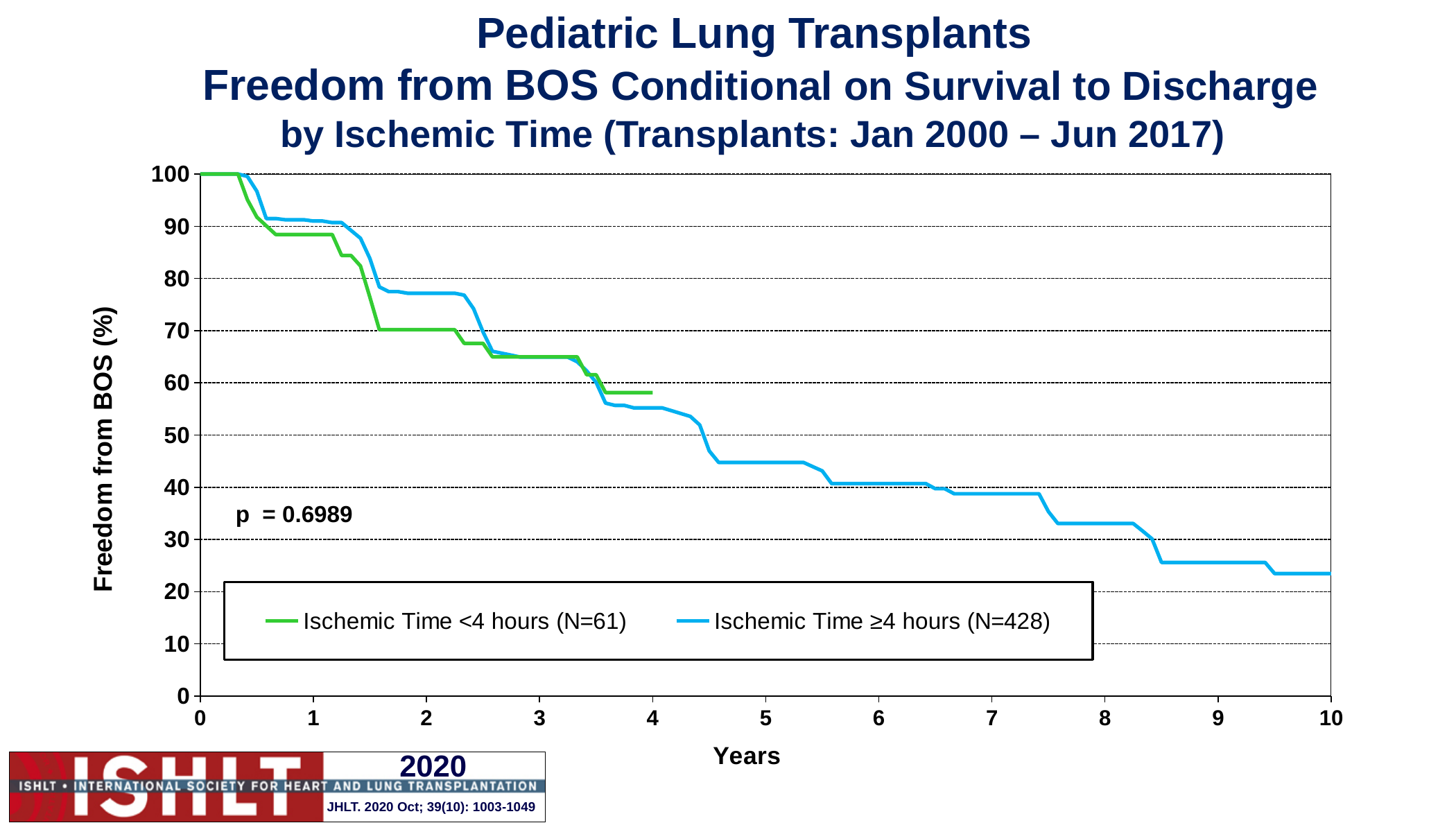
Do the Freedom from BOS values rise or fall as the years increase? fall What kind of chart is shown on the slide? Line chart Is the value for Ischemic Time ≥4 hours at 5 years greater or less than 50? less Is the value for Ischemic Time ≥4 hours at 8 years greater or less than 30? greater Is the value for Ischemic Time ≥4 hours at 10 years greater or less than 30? less How many series does the legend list? 2 At 2 years, which series has the higher Freedom from BOS value? Ischemic Time ≥4 hours (N=428) What is the Freedom from BOS (%) value for both series at 0 years? 100 How many patients (N) are in the Ischemic Time ≥4 hours group according to the legend? 428 What is the p-value printed on the chart? p = 0.6989